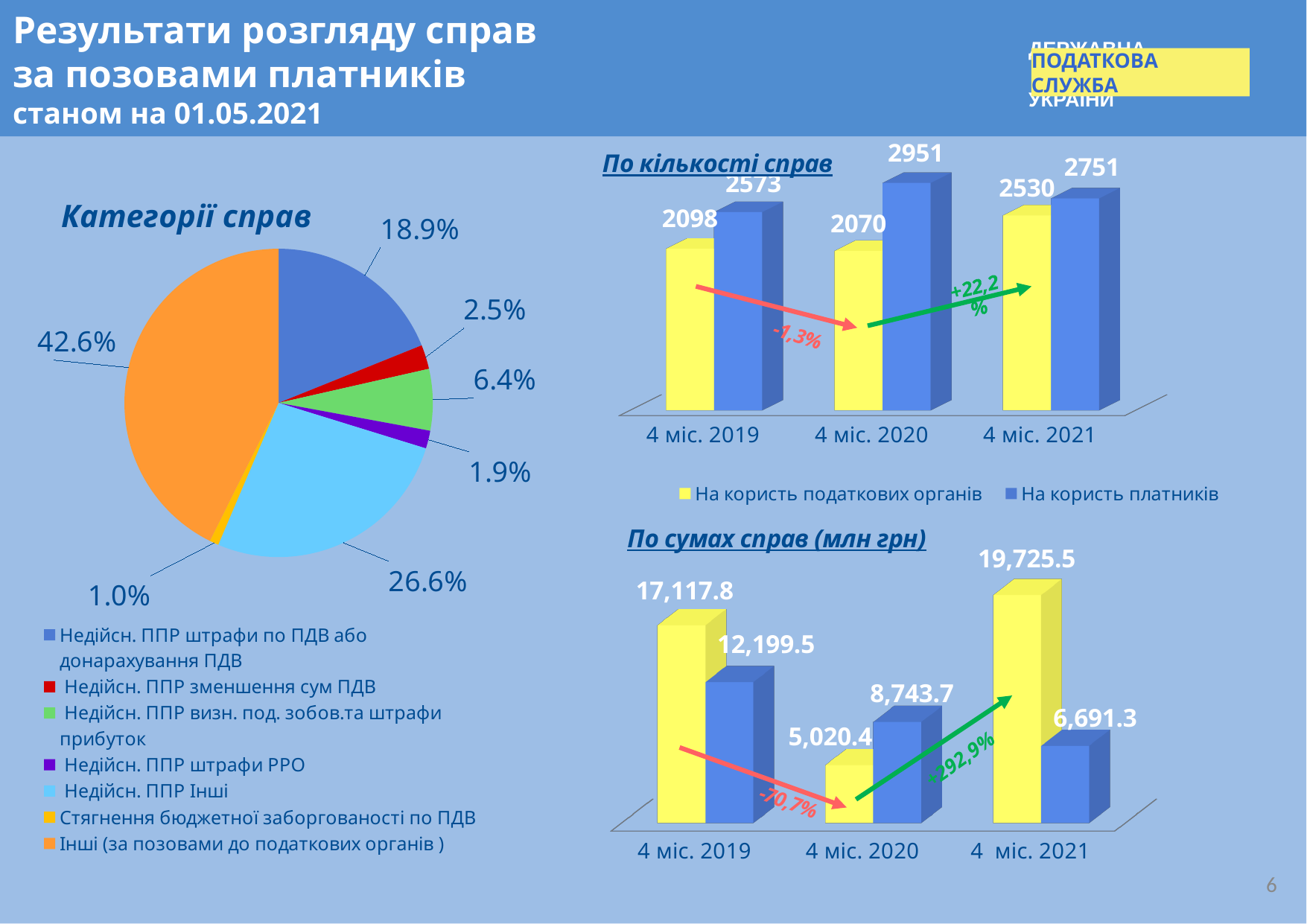
In the pie chart 'Категорії справ', which category has the smallest share? Стягнення бюджетної заборгованості по ПДВ In the chart 'По кількості справ', how many series does the legend list? 2 In the chart 'По сумах справ (млн грн)', what is the value of the yellow bar for 4 міс. 2021? 19,725.5 In the pie chart 'Категорії справ', what is the share of 'Недійсн. ППР Інші'? 26.6% In the chart 'По кількості справ', what is the value for 'На користь платників' in 4 міс. 2020? 2951 How many categories does the legend of the pie chart 'Категорії справ' list? 7 In the chart 'По сумах справ (млн грн)', which is larger in 4 міс. 2020: the yellow bar or the blue bar? the blue bar (8,743.7) What kind of chart is 'По сумах справ (млн грн)'? bar chart In the chart 'По сумах справ (млн грн)', what is the value of the blue bar for 4 міс. 2019? 12,199.5 In the chart 'По кількості справ', what is the difference between 'На користь платників' and 'На користь податкових органів' in 4 міс. 2019? 475 In the chart 'По кількості справ', what is the value for 'На користь податкових органів' in 4 міс. 2021? 2530 In the pie chart 'Категорії справ', what share does 'Інші (за позовами до податкових органів)' have? 42.6%